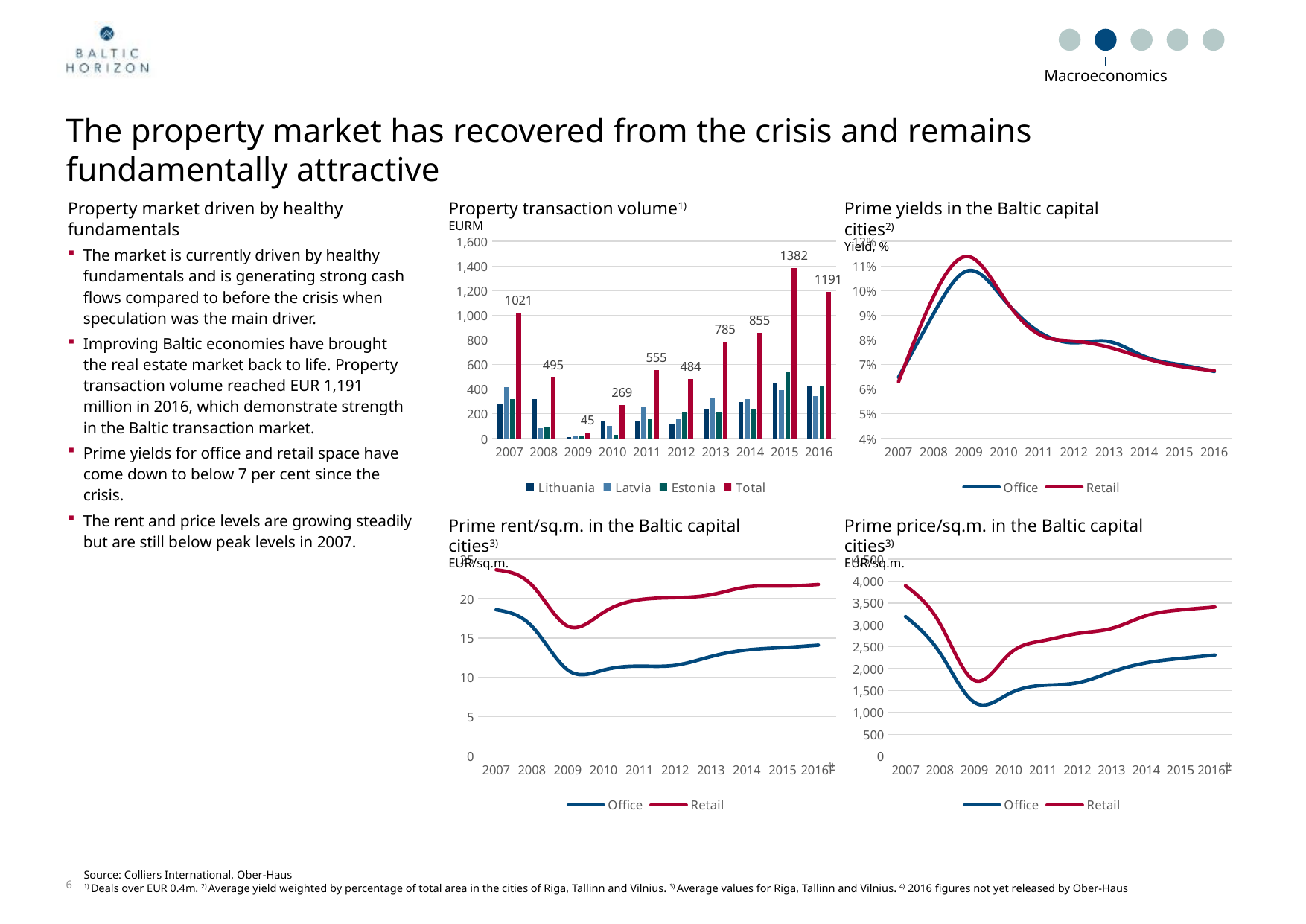
In the Prime rent/sq.m. in the Baltic capital cities chart, which two series does the legend list? Office and Retail In the Property transaction volume chart, is the Total for 2013 or 2014 larger? 2014 In the Property transaction volume chart, what is the Total value for 2009? 45 In the Property transaction volume chart, what is the difference between the Total for 2015 and the Total for 2016? 191 In the Property transaction volume chart, what is the Total value for 2016? 1191 In the Property transaction volume chart, which year has the highest Total? 2015 In the Prime price/sq.m. in the Baltic capital cities chart, does the Office line rise or fall from 2009 to 2016? rise How many years are shown on the x axis of the Property transaction volume chart? 10 What kind of chart is the Property transaction volume chart? bar chart In the Property transaction volume chart, which year has the lowest Total? 2009 In the Prime yields in the Baltic capital cities chart, is the Retail yield in 2009 greater or less than 11%? greater How many series does the legend of the Property transaction volume chart list? 4